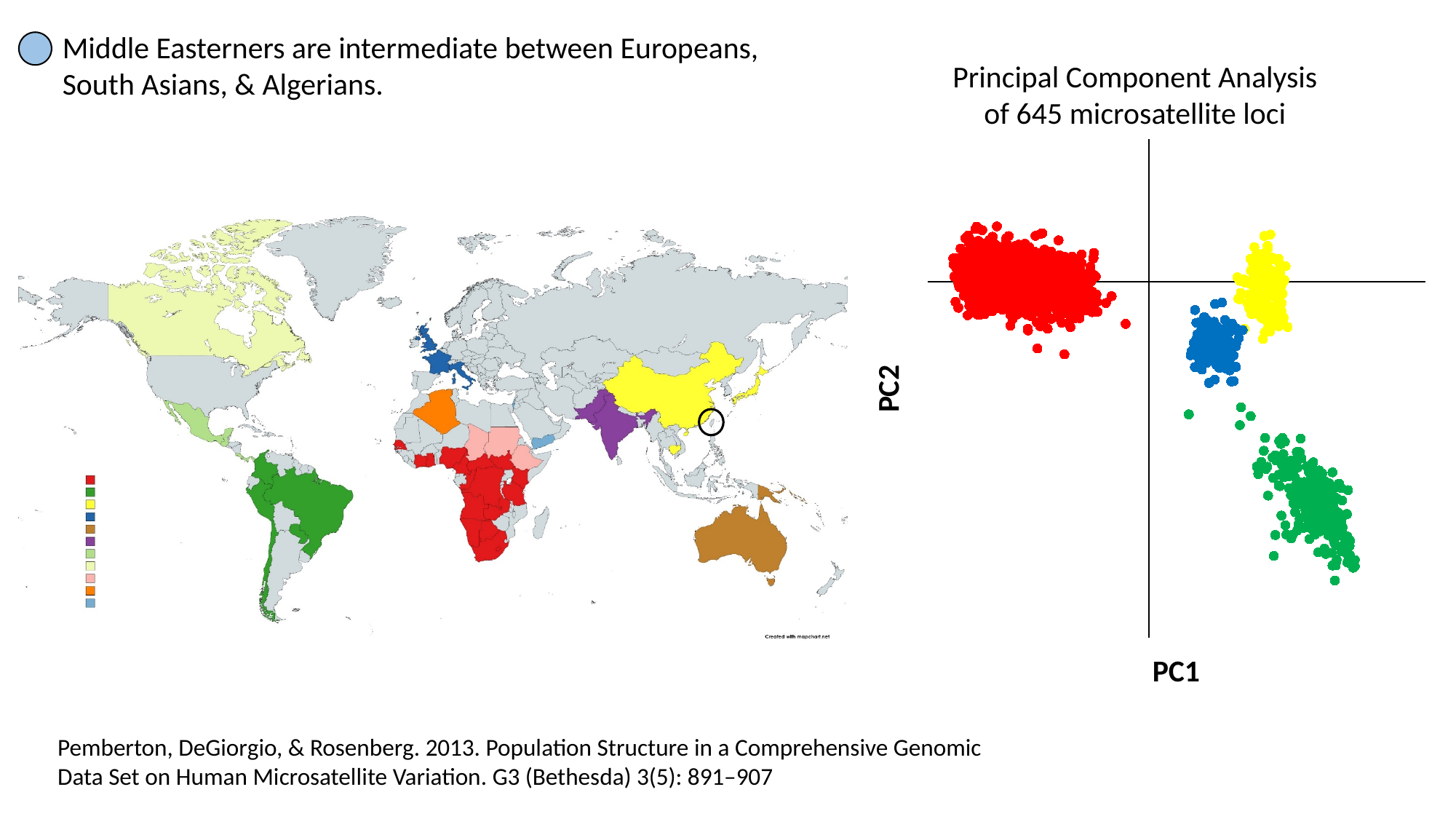
How many distinct coloured clusters of points are shown in the Principal Component Analysis chart? 4 In the Principal Component Analysis chart, which coloured cluster is furthest to the right along PC1? green In the Principal Component Analysis chart, which coloured cluster is lowest on the PC2 axis? green In the Principal Component Analysis chart, is the blue cluster above or below the yellow cluster on PC2? below In the Principal Component Analysis chart, which coloured cluster is furthest to the left along PC1? red In the Principal Component Analysis chart, which coloured cluster lies to the left of the vertical axis? red In the Principal Component Analysis chart, is the yellow cluster to the left or right of the vertical axis? right What kind of chart is the Principal Component Analysis plot on the right of the slide? scatter plot In the Principal Component Analysis chart, what are the labels of the horizontal and vertical axes? PC1 and PC2 What is the title of the chart on the right of the slide? Principal Component Analysis of 645 microsatellite loci